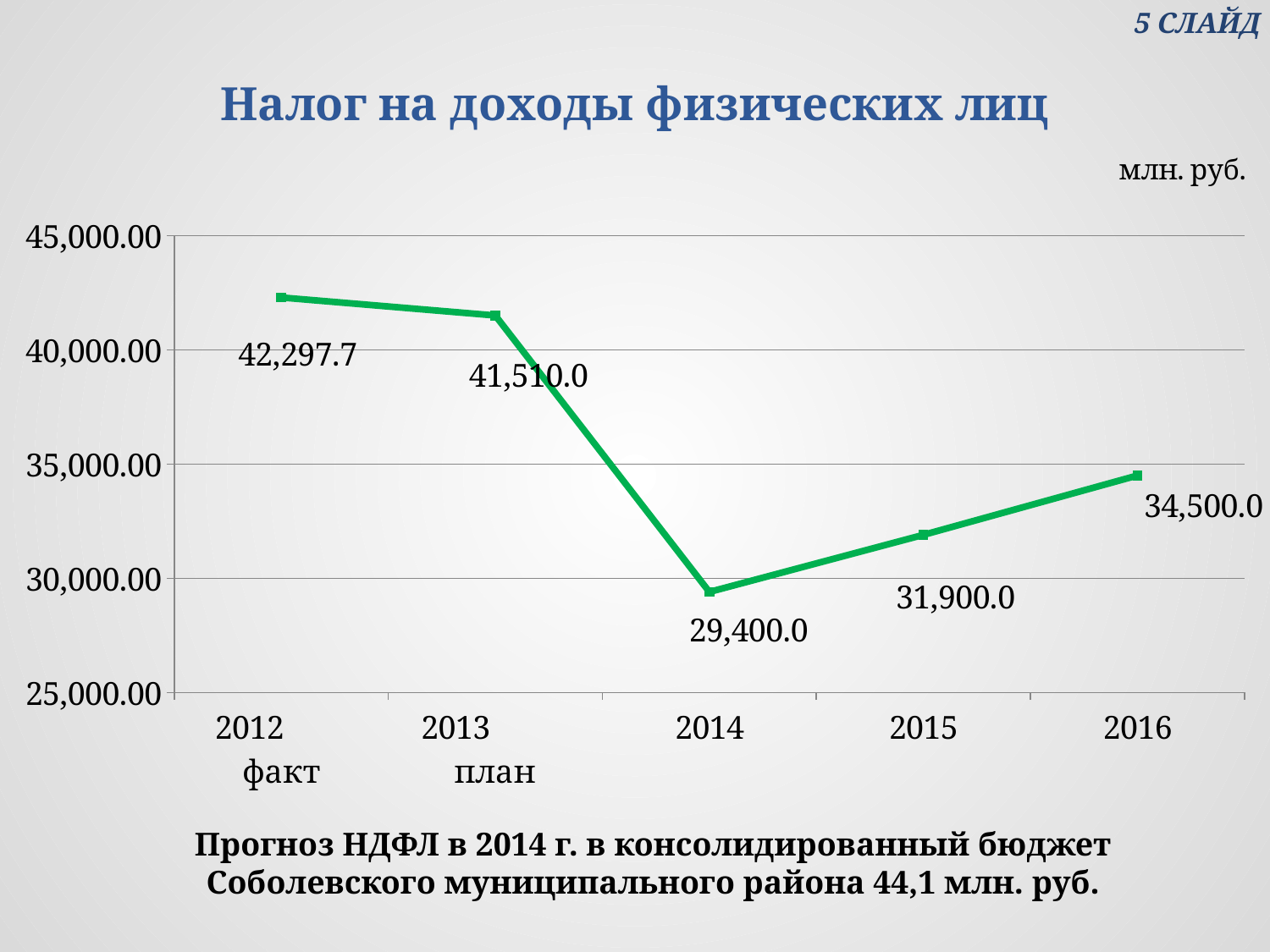
Do the values rise or fall from 2014 to 2016? rise What kind of chart is shown on the slide? line chart What is the value for 2014? 29,400.0 What is the value for 2012 факт? 42,297.7 Which is larger, the value for 2015 or the value for 2016? 2016 Which year has the lowest value? 2014 Is the value for 2014 greater or less than 30,000.00? less Which year has the highest value? 2012 факт What is the value for 2016? 34,500.0 What is the difference between the 2016 value and the 2015 value? 2,600.0 What is the difference between the 2013 план value and the 2014 value? 12,110.0 How many data points are plotted on the chart? 5